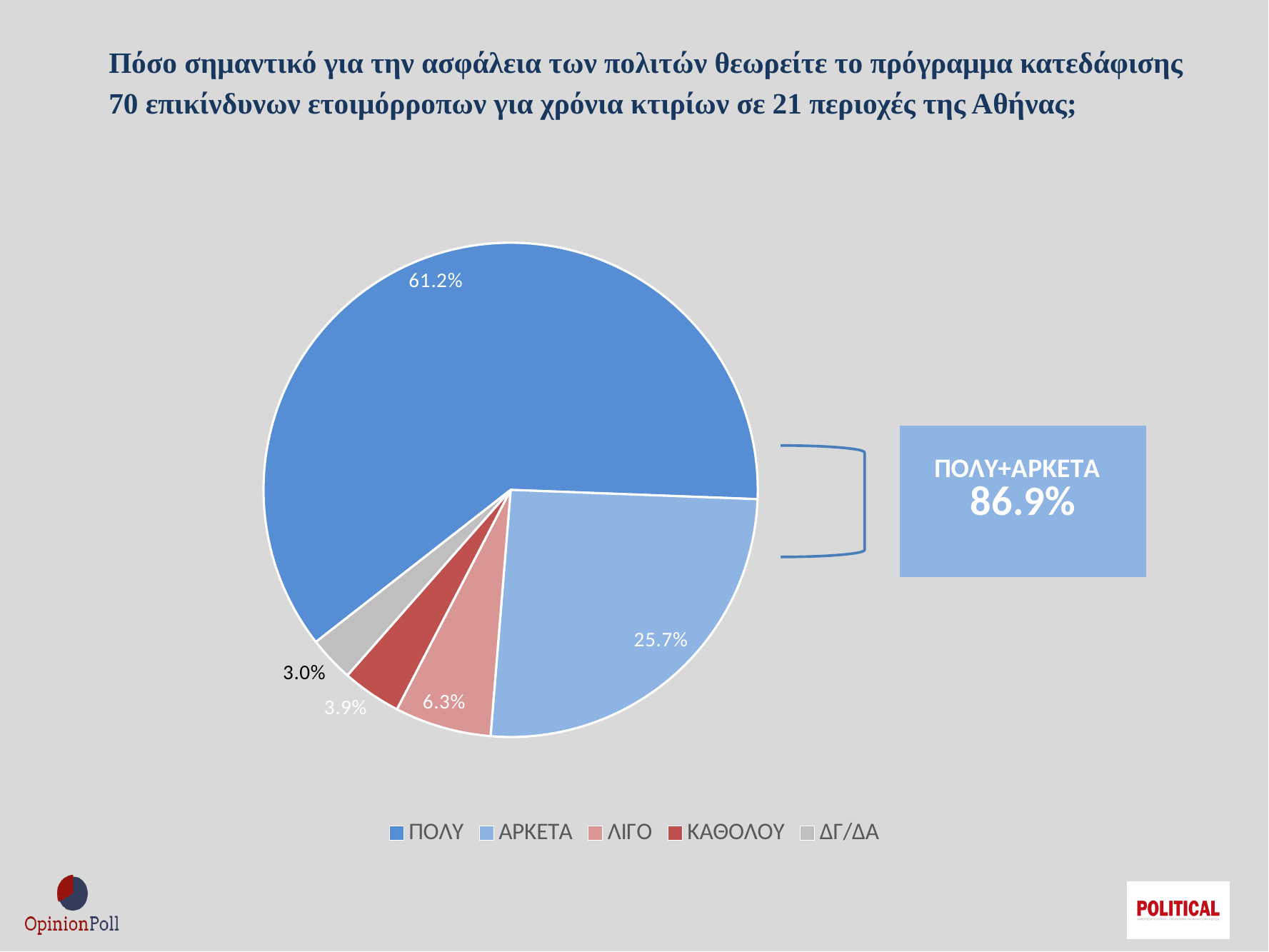
What kind of chart is shown on the slide? pie chart How many categories does the legend list? 5 Which response category has the smallest share of the pie? ΔΓ/ΔΑ What is the difference in percentage points between ΠΟΛΥ and ΑΡΚΕΤΑ? 35.5 What percentage of respondents answered ΔΓ/ΔΑ? 3.0% What percentage of respondents answered ΠΟΛΥ? 61.2% What combined percentage is shown in the box for ΠΟΛΥ+ΑΡΚΕΤΑ? 86.9% Which response category has the largest share of the pie? ΠΟΛΥ What percentage of respondents answered ΚΑΘΟΛΟΥ? 3.9% What percentage of respondents answered ΛΙΓΟ? 6.3% What percentage of respondents answered ΑΡΚΕΤΑ? 25.7% Which is larger, the share for ΛΙΓΟ or the share for ΚΑΘΟΛΟΥ? ΛΙΓΟ